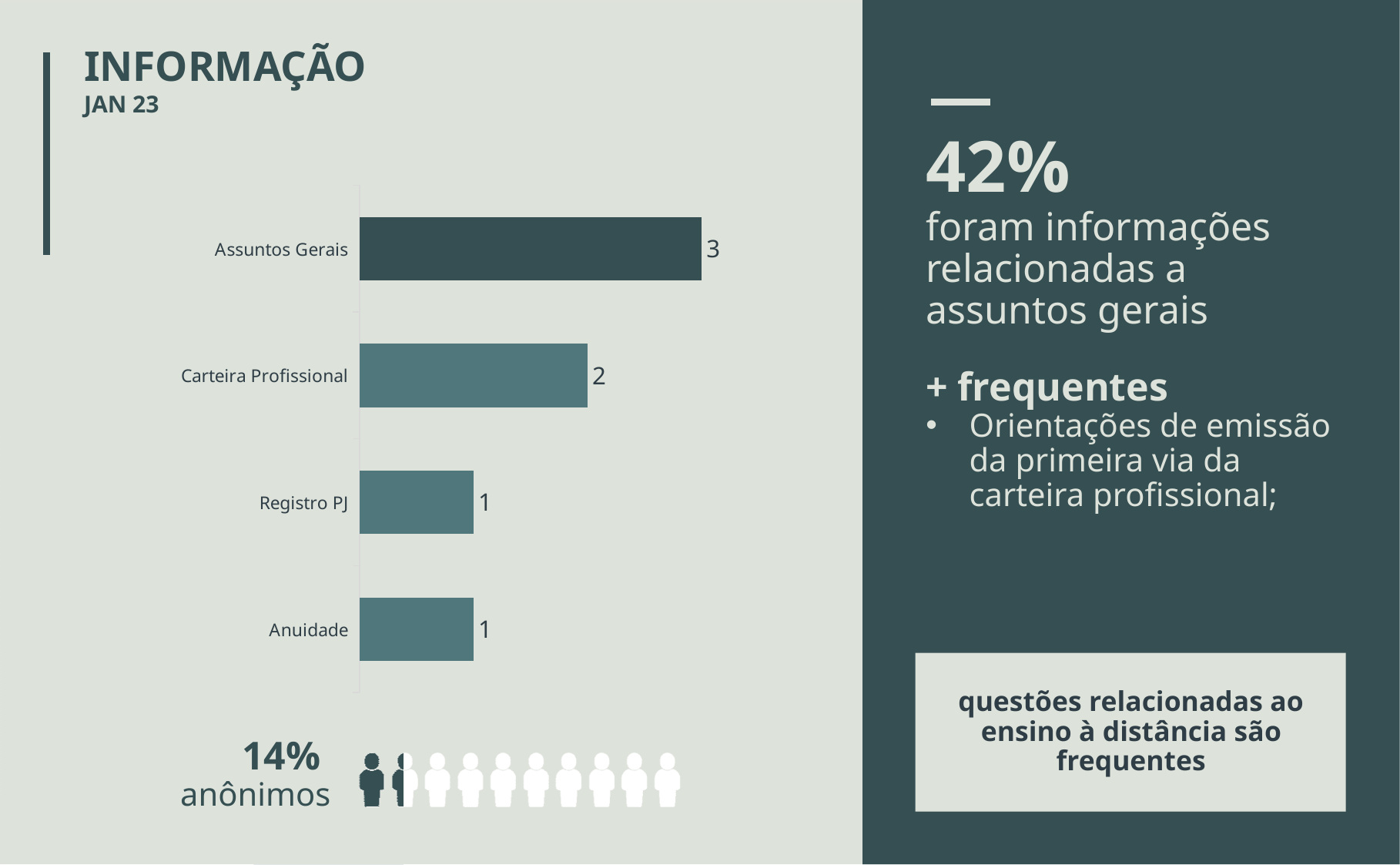
What is the value for Registro PJ? 1 What is the value for Carteira Profissional? 2 What is the difference between the values for Assuntos Gerais and Anuidade? 2 Which is larger, the value for Carteira Profissional or the value for Registro PJ? Carteira Profissional What is the value for Anuidade? 1 Which category's bar is drawn in a darker colour than the others? Assuntos Gerais How many categories are shown in the chart? 4 Which category has the highest value? Assuntos Gerais What is the total of all the values shown in the chart? 7 What is the value for Assuntos Gerais? 3 What is the difference between the values for Assuntos Gerais and Carteira Profissional? 1 What kind of chart is shown on the slide? bar chart